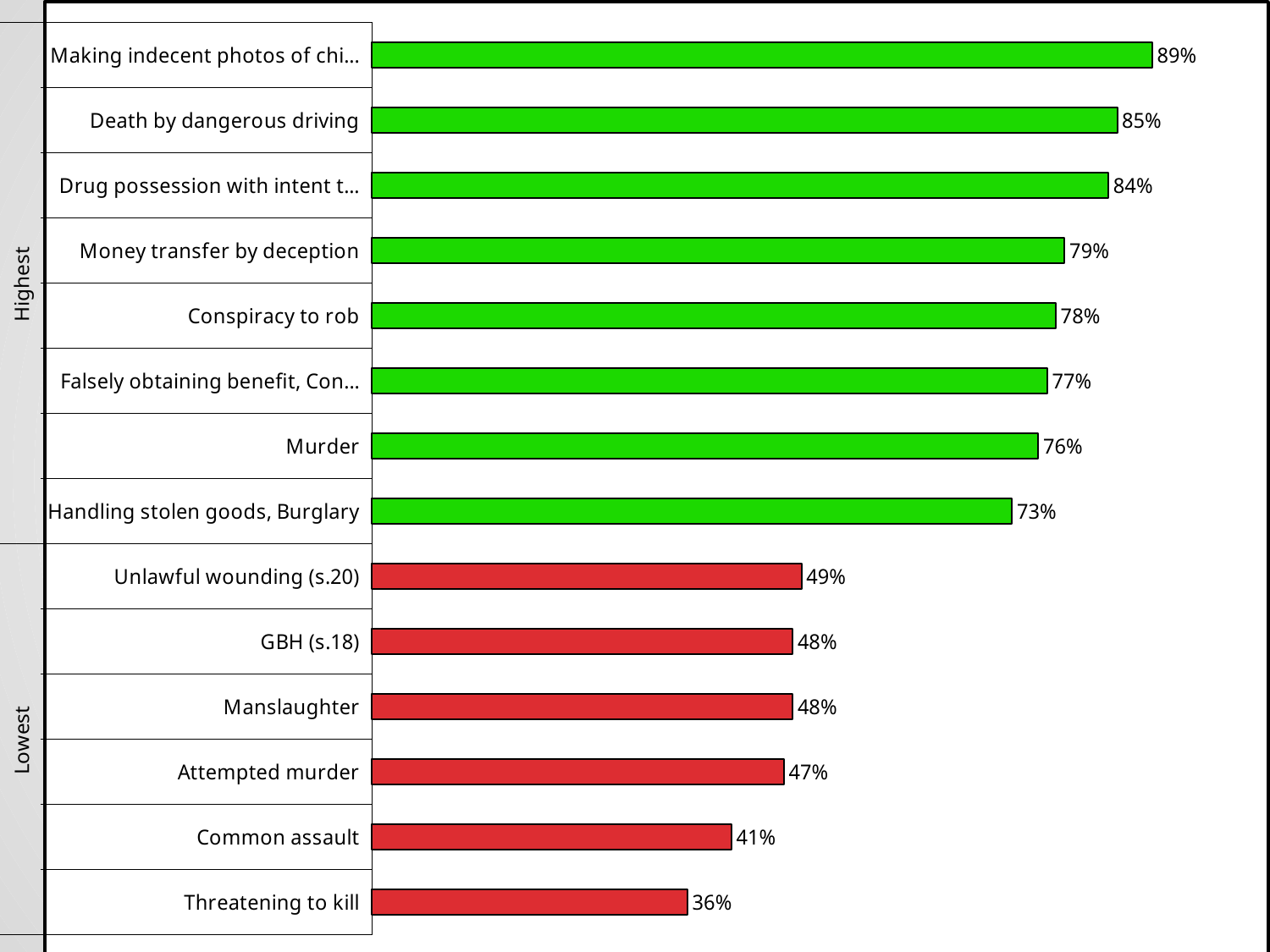
Which is larger, the value for Money transfer by deception or the value for Handling stolen goods, Burglary? Money transfer by deception What is the difference between the values for Conspiracy to rob and Attempted murder? 31% Which category has the highest value? Making indecent photos of chi... How many categories are shown in the chart? 14 Which category has the lowest value? Threatening to kill How many categories are in the Lowest group? 6 What kind of chart is this? Bar chart What colour are the bars in the Lowest group? Red What is the value for Common assault? 41% What is the value for Death by dangerous driving? 85% What is the value for Threatening to kill? 36% What is the value for Murder? 76%